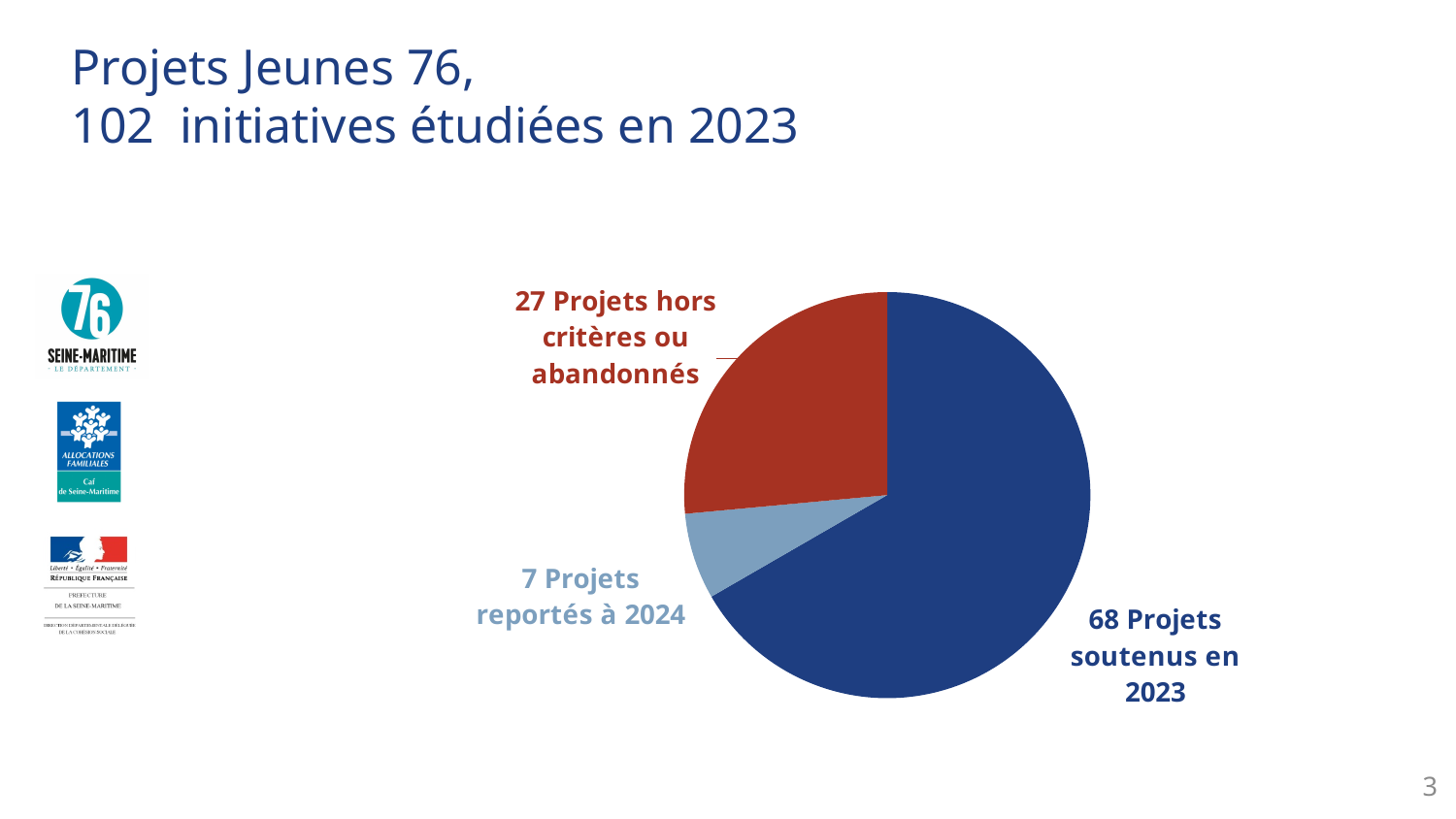
Out of the 102 initiatives studied, how many does the 'Projets soutenus en 2023' slice represent? 68 out of 102 Which category has the smallest slice of the pie? Projets reportés à 2024 What is the difference between the number of projects supported in 2023 and the number of projects outside criteria or abandoned? 41 Which category has the largest slice of the pie? Projets soutenus en 2023 How many slices does the pie chart have? 3 How many projects were outside the criteria or abandoned (projets hors critères ou abandonnés)? 27 Which is larger: the number of projects outside criteria or abandoned, or the number of projects postponed to 2024? Projets hors critères ou abandonnés What kind of chart is shown on the slide? Pie chart What is the total number of projects across all three slices of the pie? 102 How many projects were postponed to 2024 (projets reportés à 2024)? 7 How many projects were supported in 2023 (projets soutenus en 2023)? 68 What colour is the slice for 'Projets hors critères ou abandonnés'? Red